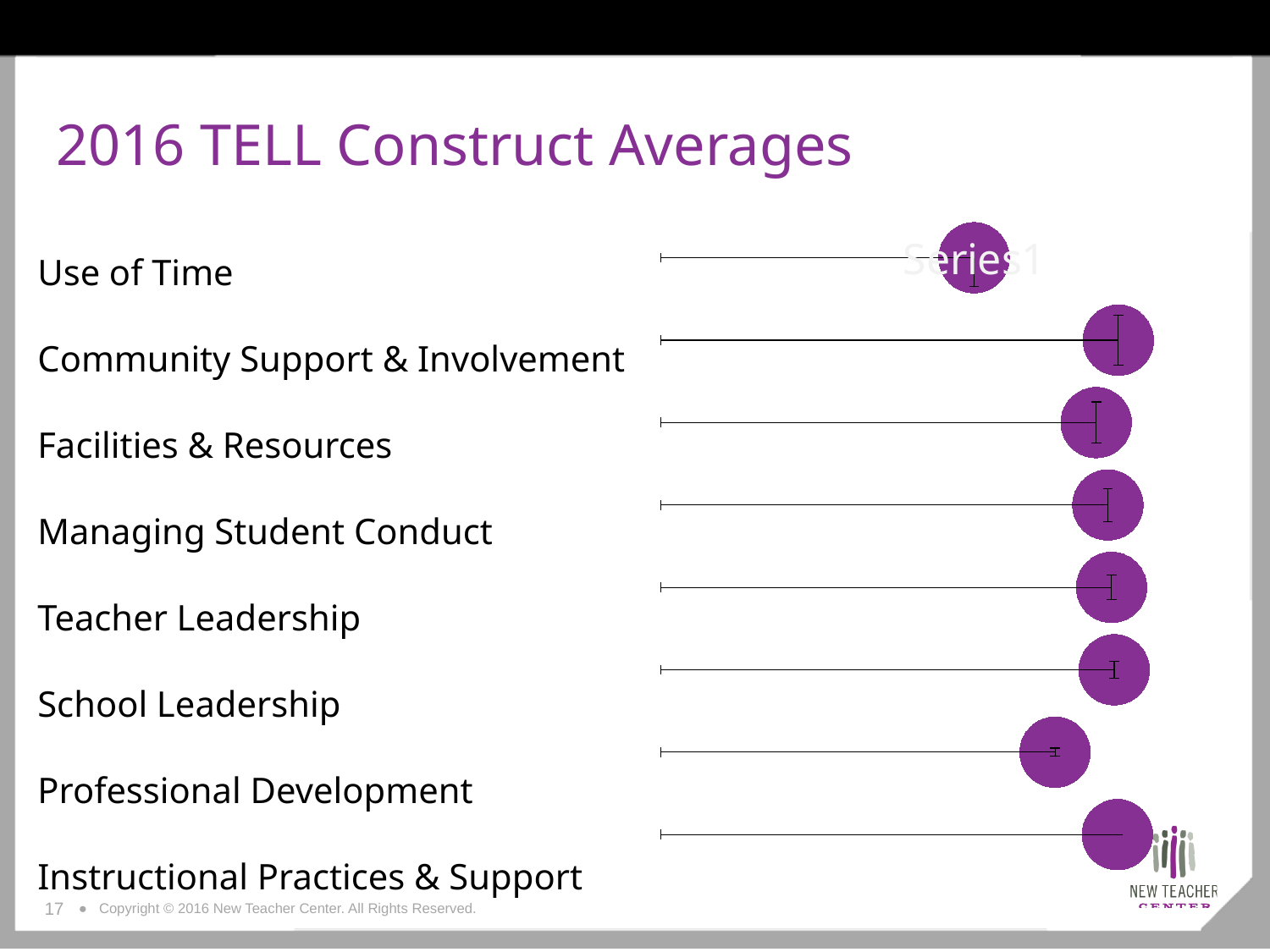
Which has the larger value, Use of Time or Facilities & Resources? Facilities & Resources What is the title of the chart on the slide? 2016 TELL Construct Averages Which construct is listed first (at the top) of the chart? Use of Time Which has the larger value, Professional Development or Community Support & Involvement? Community Support & Involvement Which construct is listed last (at the bottom) of the chart? Instructional Practices & Support Which construct has the lowest average in the chart? Use of Time Which has the larger value, Professional Development or Teacher Leadership? Teacher Leadership How many constructs (categories) are plotted in the chart? 8 How many data series does the chart plot? 1